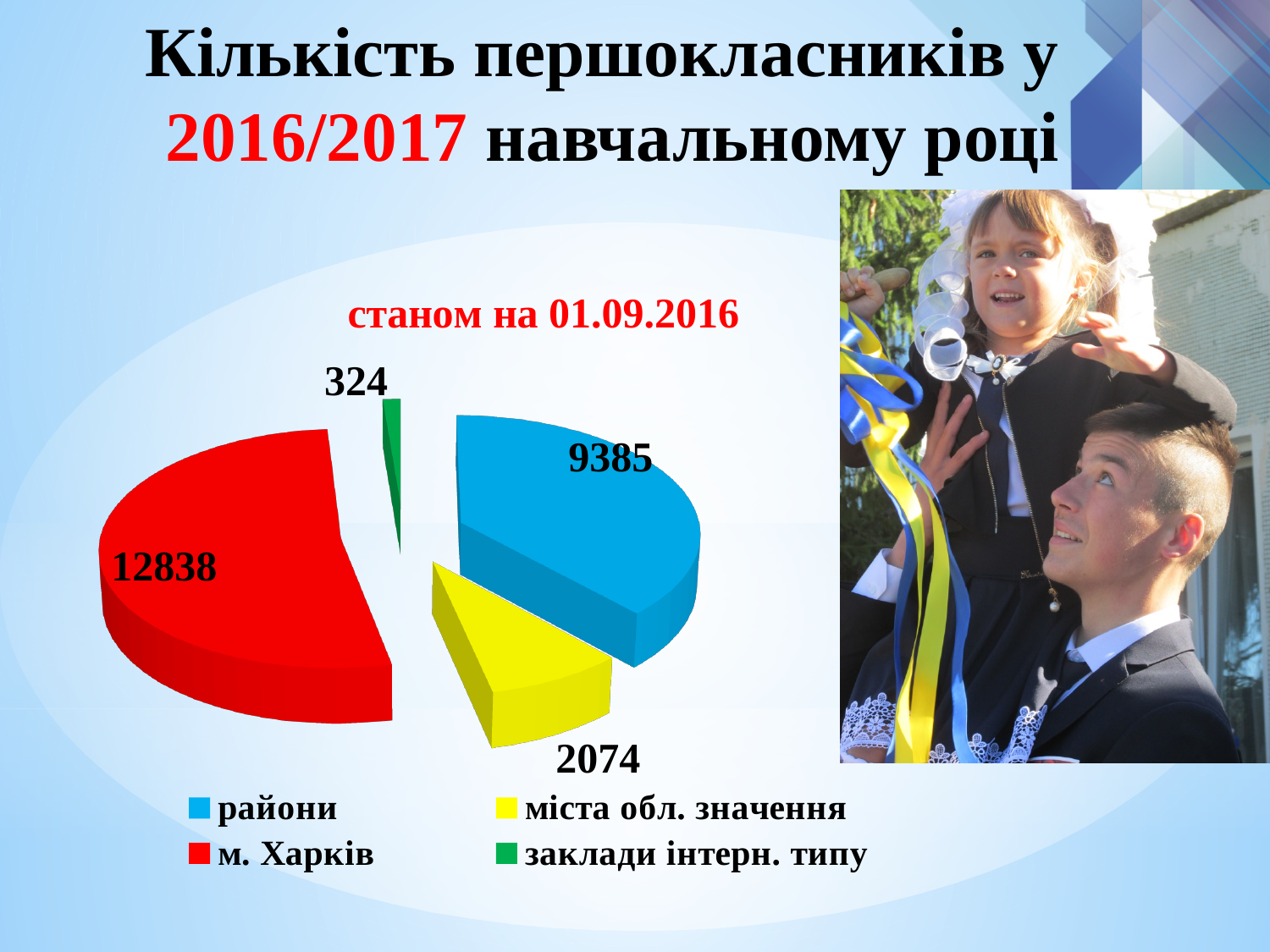
What is the difference between the values for м. Харків and райони? 3453 Which category has the smallest slice of the pie? заклади інтерн. типу What is the value for міста обл. значення? 2074 Which category has the largest slice of the pie? м. Харків What is the value for м. Харків? 12838 How many first-graders are shown for райони? 9385 What is the total of all four slices of the pie? 24621 What is the value for заклади інтерн. типу? 324 What colour is the slice for м. Харків? Red How many categories does the pie chart have? 4 Which is larger, the value for райони or the value for міста обл. значення? райони What kind of chart is shown on the slide? Pie chart